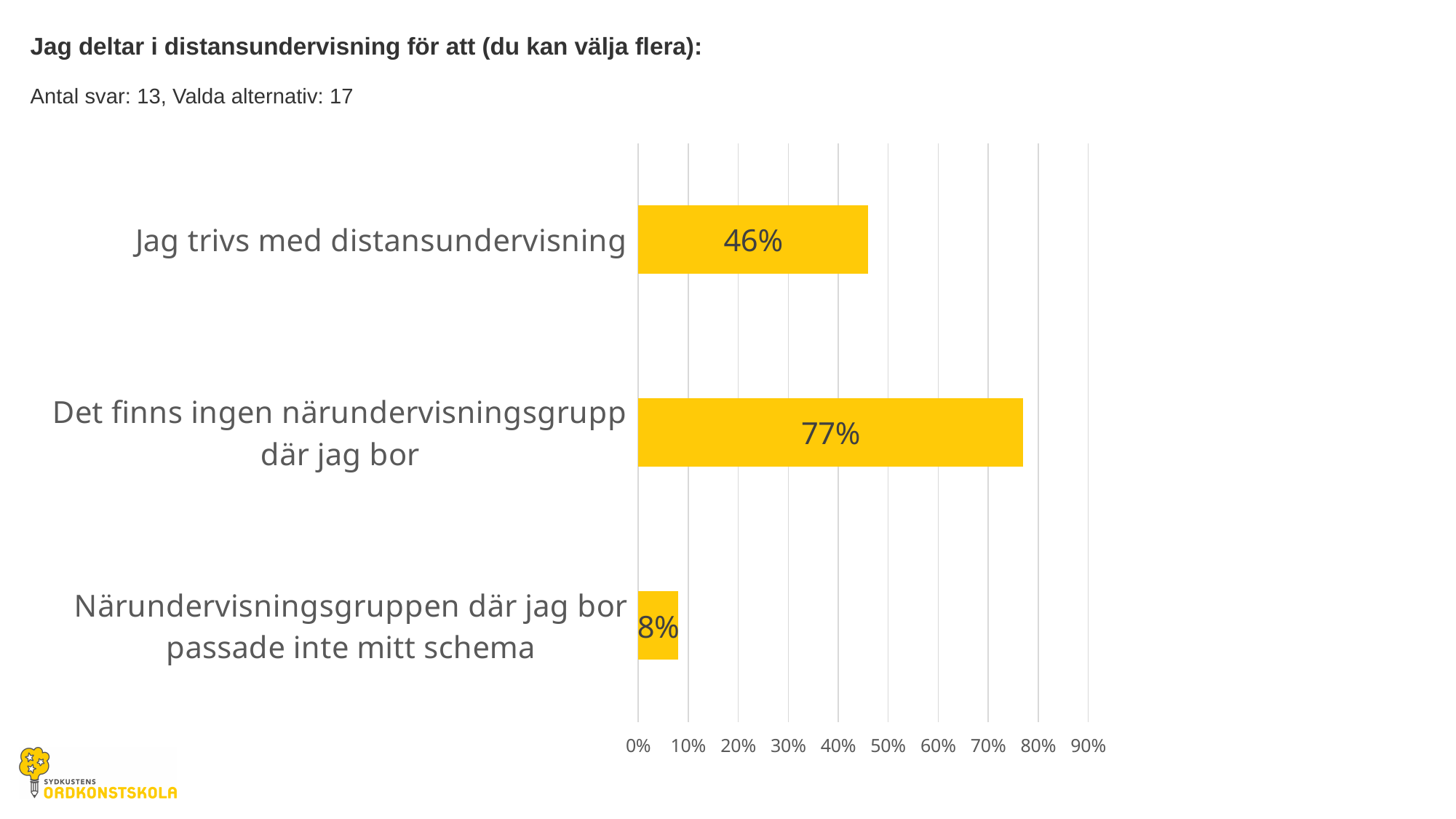
What is the value for "Det finns ingen närundervisningsgrupp där jag bor"? 77% Is the value for "Det finns ingen närundervisningsgrupp där jag bor" greater or less than 70%? greater What is the value for "Jag trivs med distansundervisning"? 46% How many categories are shown in the chart? 3 What is the title of the chart? Jag deltar i distansundervisning för att (du kan välja flera): What is the difference between the values for "Det finns ingen närundervisningsgrupp där jag bor" and "Jag trivs med distansundervisning"? 31% What is the value for "Närundervisningsgruppen där jag bor passade inte mitt schema"? 8% What is the difference between the values for "Jag trivs med distansundervisning" and "Närundervisningsgruppen där jag bor passade inte mitt schema"? 38% Which category has the lowest value? Närundervisningsgruppen där jag bor passade inte mitt schema Which is larger: the value for "Jag trivs med distansundervisning" or the value for "Närundervisningsgruppen där jag bor passade inte mitt schema"? Jag trivs med distansundervisning What kind of chart is shown on the slide? bar chart Which category has the highest value? Det finns ingen närundervisningsgrupp där jag bor